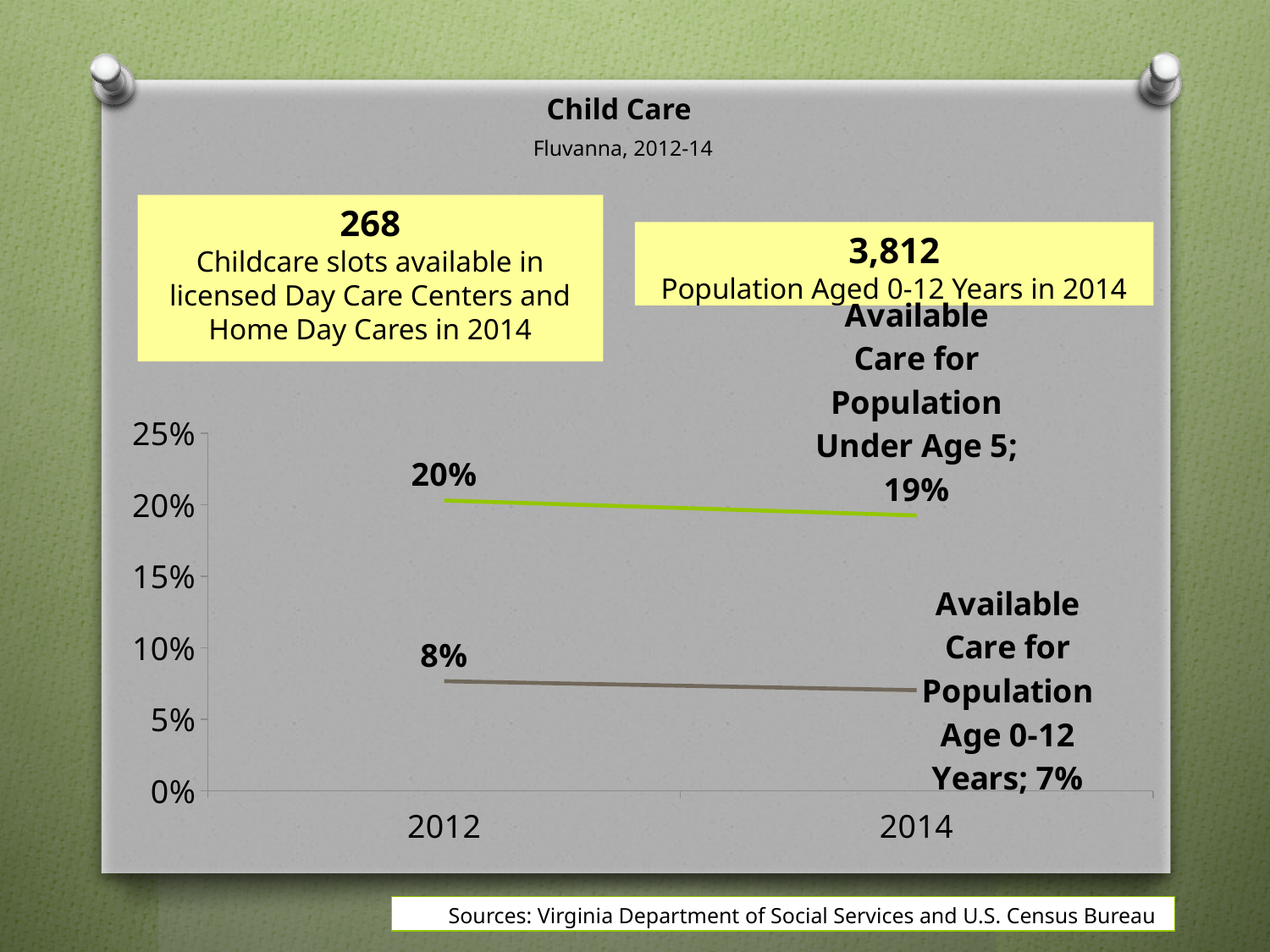
What is the value for Available Care for Population Age 0-12 Years in 2012? 8% What is the difference between the two series' values in 2012? 12% What is the difference between the 2012 and 2014 values for Available Care for Population Age 0-12 Years? 1% How many years are shown on the x axis of the chart? 2 How many data series are plotted on the chart? 2 What is the value for Available Care for Population Under Age 5 in 2014? 19% What type of chart is shown on the slide? Line chart What is the title of the chart? Child Care Does the Available Care for Population Under Age 5 line rise or fall from 2012 to 2014? Fall What is the value for Available Care for Population Age 0-12 Years in 2014? 7% In 2014, which series has the higher value: Available Care for Population Under Age 5 or Available Care for Population Age 0-12 Years? Available Care for Population Under Age 5 What is the value for Available Care for Population Under Age 5 in 2012? 20%